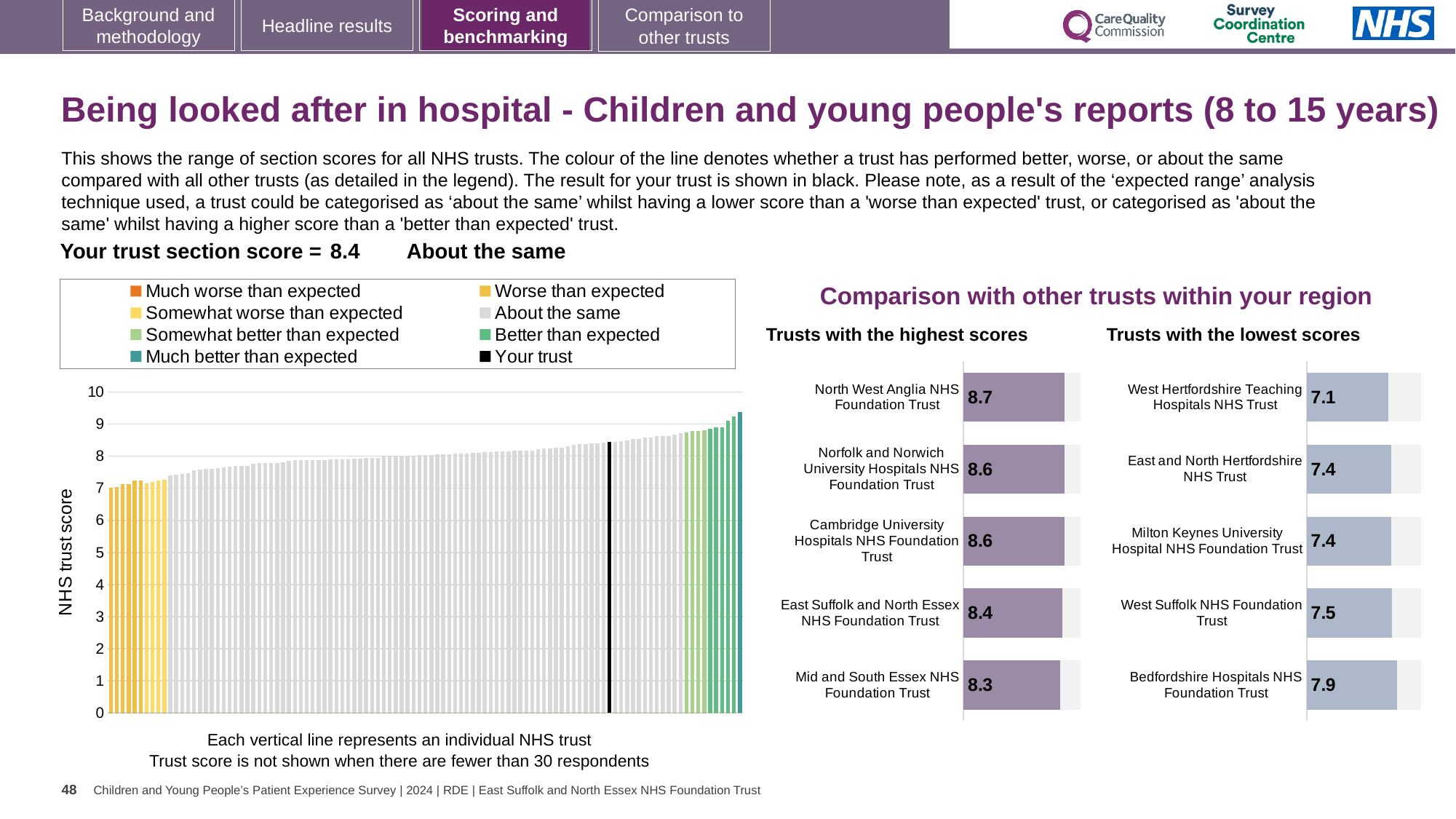
In the large chart on the left, do the bar values rise or fall from left to right? Rise What kind of chart is the large chart on the left showing all NHS trust scores? Bar chart In the 'Trusts with the highest scores' chart, what is the difference between the scores of North West Anglia NHS Foundation Trust and Mid and South Essex NHS Foundation Trust? 0.4 What is the y-axis label of the large chart on the left? NHS trust score In the 'Trusts with the highest scores' chart, what is the score for North West Anglia NHS Foundation Trust? 8.7 In the 'Trusts with the lowest scores' chart, which has the higher score: West Suffolk NHS Foundation Trust or Milton Keynes University Hospital NHS Foundation Trust? West Suffolk NHS Foundation Trust In the 'Trusts with the lowest scores' chart, what is the difference between the scores of Bedfordshire Hospitals NHS Foundation Trust and West Hertfordshire Teaching Hospitals NHS Trust? 0.8 In the 'Trusts with the highest scores' chart, which trust has the lowest score? Mid and South Essex NHS Foundation Trust In the large chart on the left, is the value for the black 'Your trust' bar greater or less than 8? greater In the 'Trusts with the highest scores' chart, how many trusts are shown? 5 In the 'Trusts with the lowest scores' chart, which trust has the highest score? Bedfordshire Hospitals NHS Foundation Trust In the 'Trusts with the lowest scores' chart, what is the score for West Hertfordshire Teaching Hospitals NHS Trust? 7.1